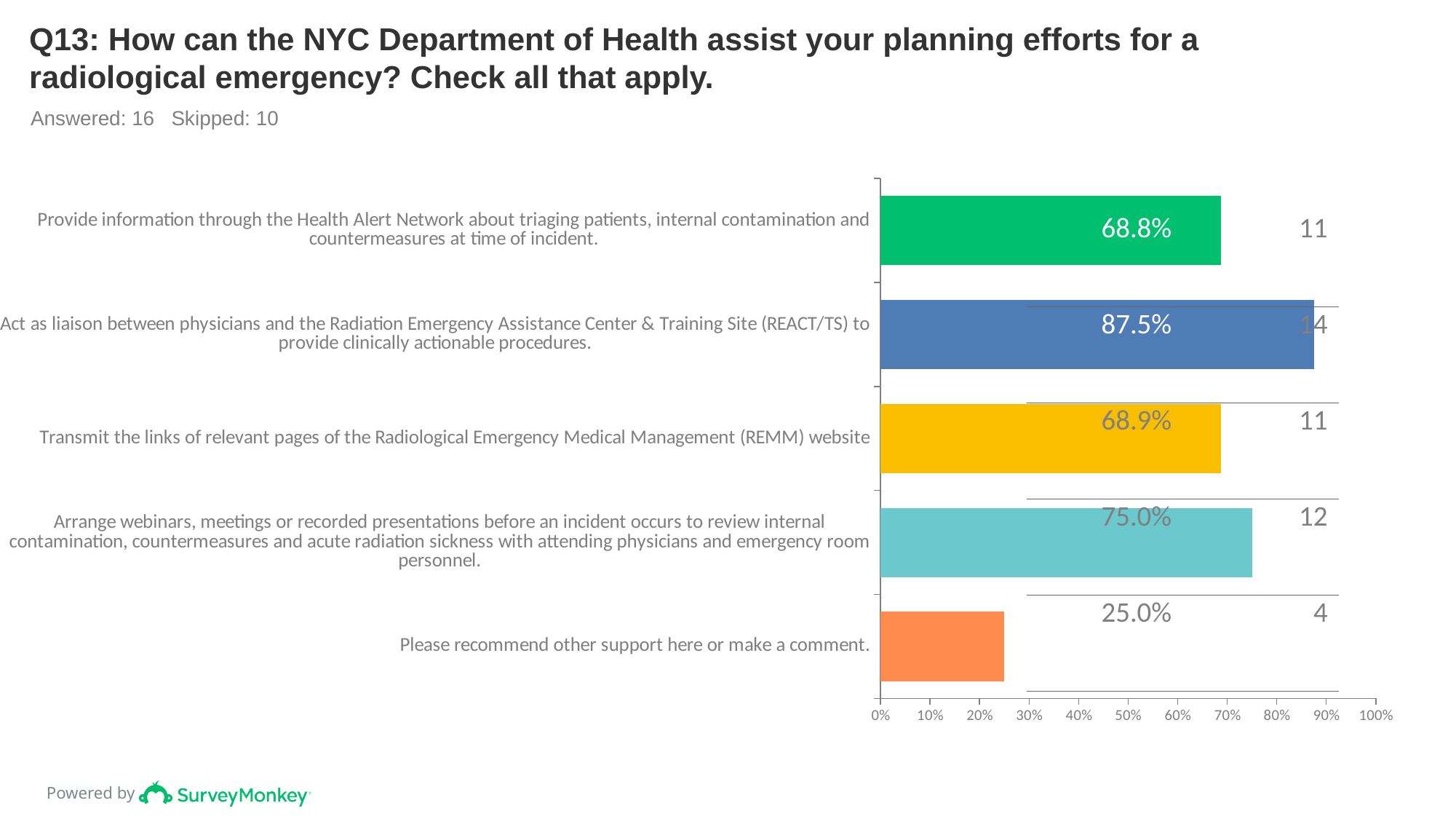
Which option has the lowest percentage of respondents? Please recommend other support here or make a comment. What is the difference in percentage points between the REACT/TS liaison option (87.5%) and the webinars option (75.0%)? 12.5 percentage points What type of chart is shown on the slide? Bar chart How many more respondents chose the REACT/TS liaison option than the webinars option? 2 What percentage is shown for "Transmit the links of relevant pages of the Radiological Emergency Medical Management (REMM) website"? 68.9% Which received a higher percentage: the webinars option or the Health Alert Network option? The webinars option How many answer options are shown in the chart? 5 What percentage is shown for "Please recommend other support here or make a comment"? 25.0% What percentage of respondents selected "Act as liaison between physicians and the Radiation Emergency Assistance Center & Training Site (REACT/TS) to provide clinically actionable procedures"? 87.5% Is the value for "Please recommend other support here or make a comment" greater or less than 30%? less Which option has the highest percentage of respondents? Act as liaison between physicians and the Radiation Emergency Assistance Center & Training Site (REACT/TS) to provide clinically actionable procedures. How many respondents selected "Arrange webinars, meetings or recorded presentations before an incident occurs..."? 12